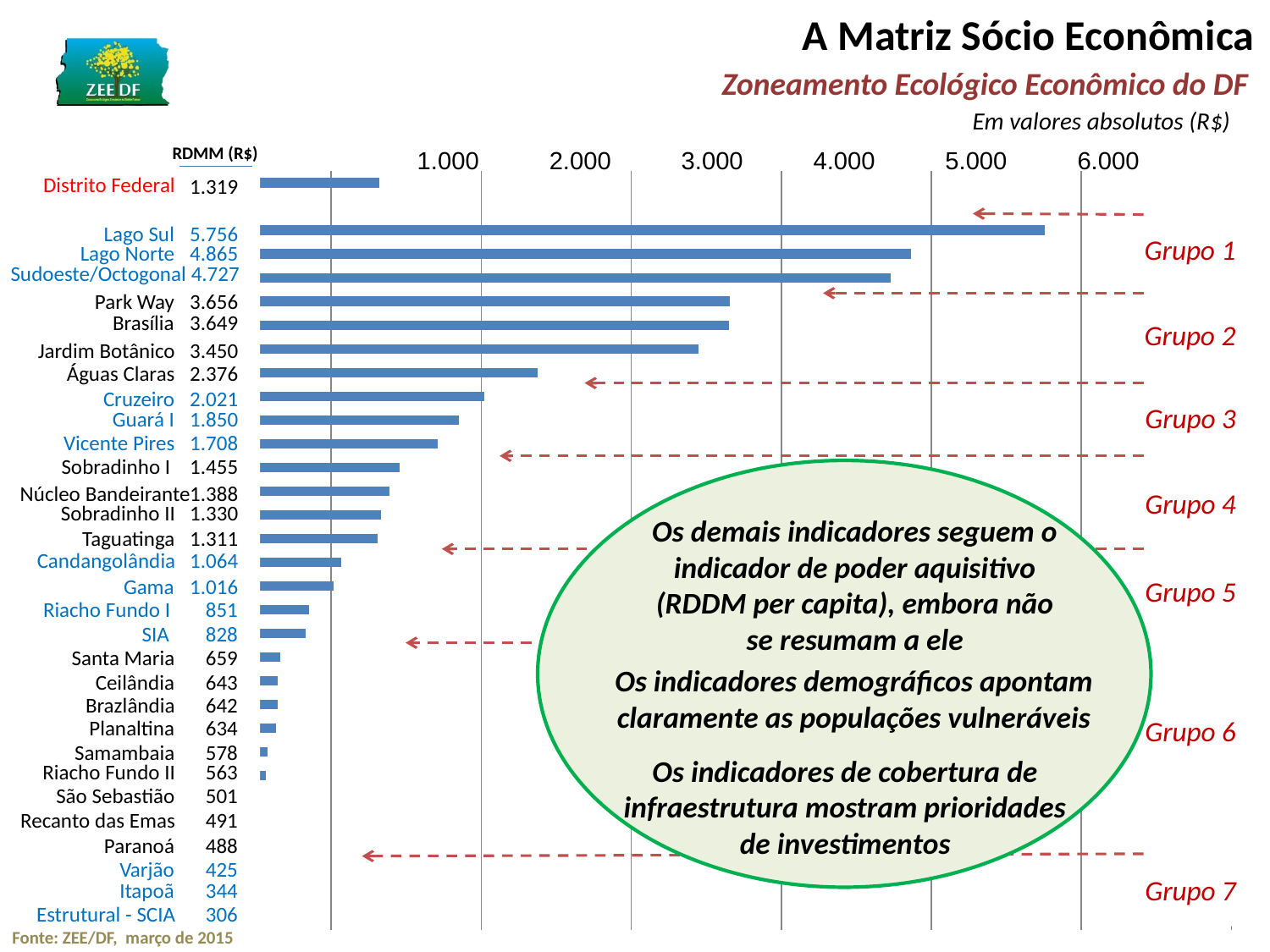
What is the RDMM (R$) value for Taguatinga? 1.311 Which region has the lowest RDMM (R$) value? Estrutural - SCIA Is the RDMM value for Jardim Botânico greater or less than 3.000? greater Which region has the highest RDMM (R$) value? Lago Sul What is the highest tick value shown on the chart's horizontal axis? 6.000 Is the RDMM value for Gama greater or less than 2.000? less What kind of chart is shown on the slide? Bar chart What is the difference between the RDMM values of Lago Sul and Lago Norte? 891 What is the RDMM (R$) value for Lago Sul? 5.756 What is the RDMM (R$) value for Distrito Federal? 1.319 What is the RDMM (R$) value for Estrutural - SCIA? 306 Which has a larger RDMM value, Águas Claras or Cruzeiro? Águas Claras